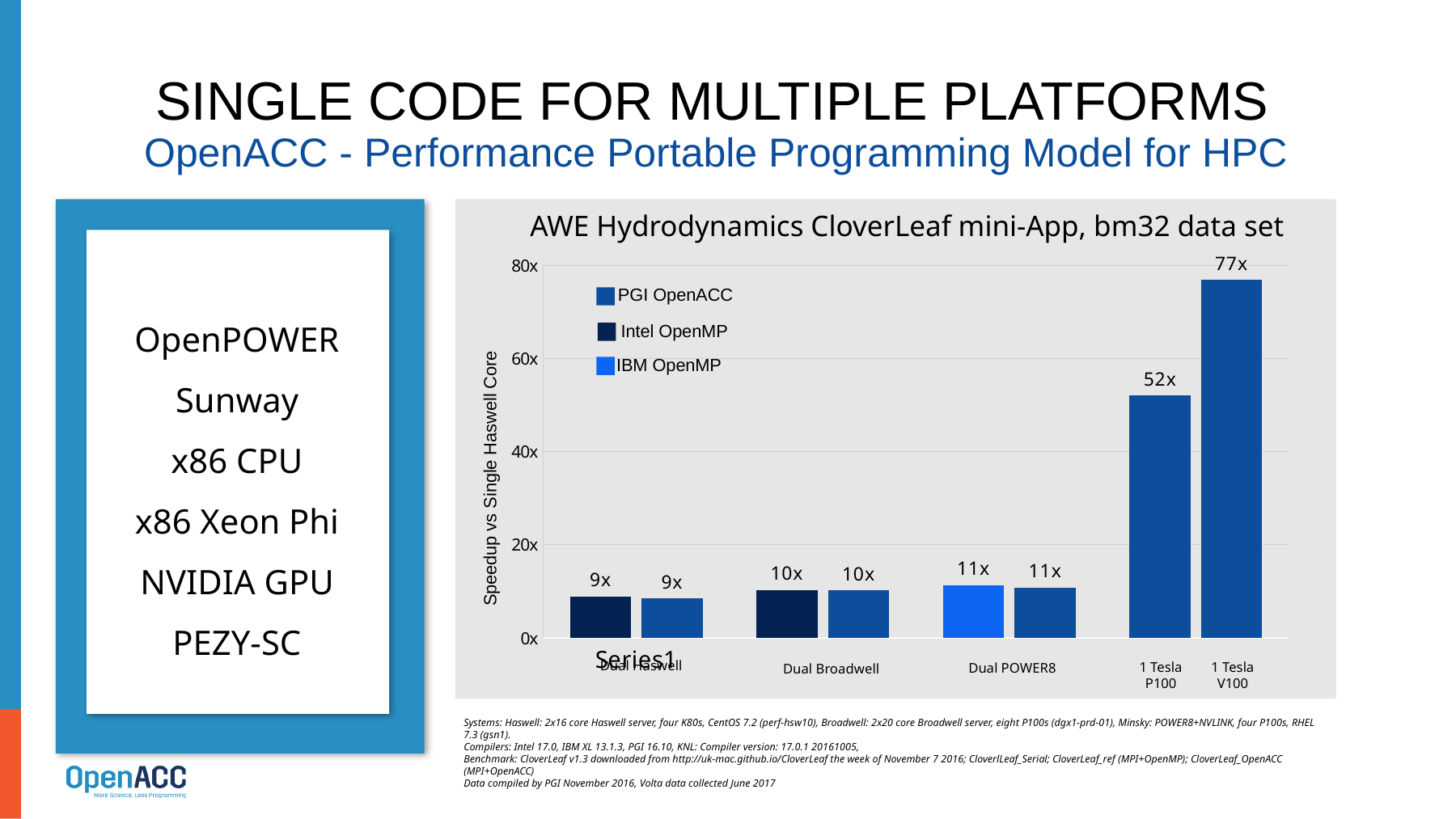
What is the speedup shown for 1 Tesla P100? 52x Which has a larger speedup, 1 Tesla P100 or Dual POWER8 with PGI OpenACC? 1 Tesla P100 What is the label of the vertical axis of the chart? Speedup vs Single Haswell Core What is the difference in speedup between 1 Tesla V100 and 1 Tesla P100? 25x What is the lowest speedup value labelled in the chart? 9x What is the speedup shown for 1 Tesla V100? 77x What speedup is shown for the IBM OpenMP bar on Dual POWER8? 11x What speedup is shown for the PGI OpenACC bar on Dual Broadwell? 10x Is the speedup for 1 Tesla P100 greater or less than 40x? greater What kind of chart is shown on the slide? Bar chart How many series does the legend list? 3 Which platform has the highest speedup in the chart? 1 Tesla V100